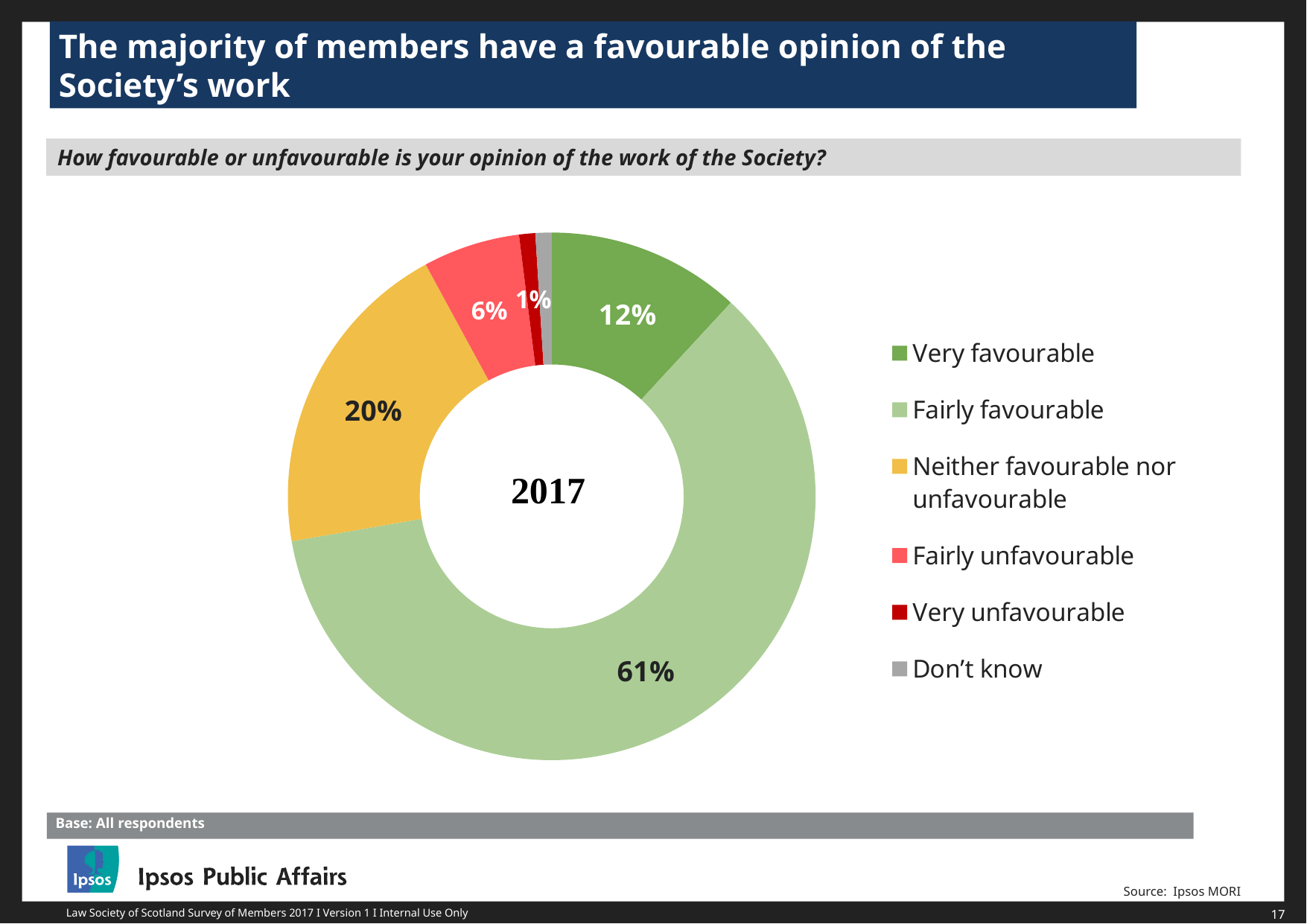
Which is larger: the share for very favourable or the share for neither favourable nor unfavourable? Neither favourable nor unfavourable What type of chart is shown on the slide? Pie (donut) chart What is the difference in percentage points between the neither favourable nor unfavourable share and the fairly unfavourable share? 14 percentage points What colour represents the 'Fairly favourable' category in the chart? Light green What is the difference in percentage points between the fairly favourable and very favourable shares? 49 percentage points What share of respondents were neither favourable nor unfavourable? 20% Which response category has the largest share of the pie? Fairly favourable How many response categories does the legend list? 6 What percentage of respondents were fairly unfavourable? 6% What year is shown in the centre of the chart? 2017 What percentage of respondents said they were fairly favourable? 61% What percentage of respondents said they were very favourable? 12%